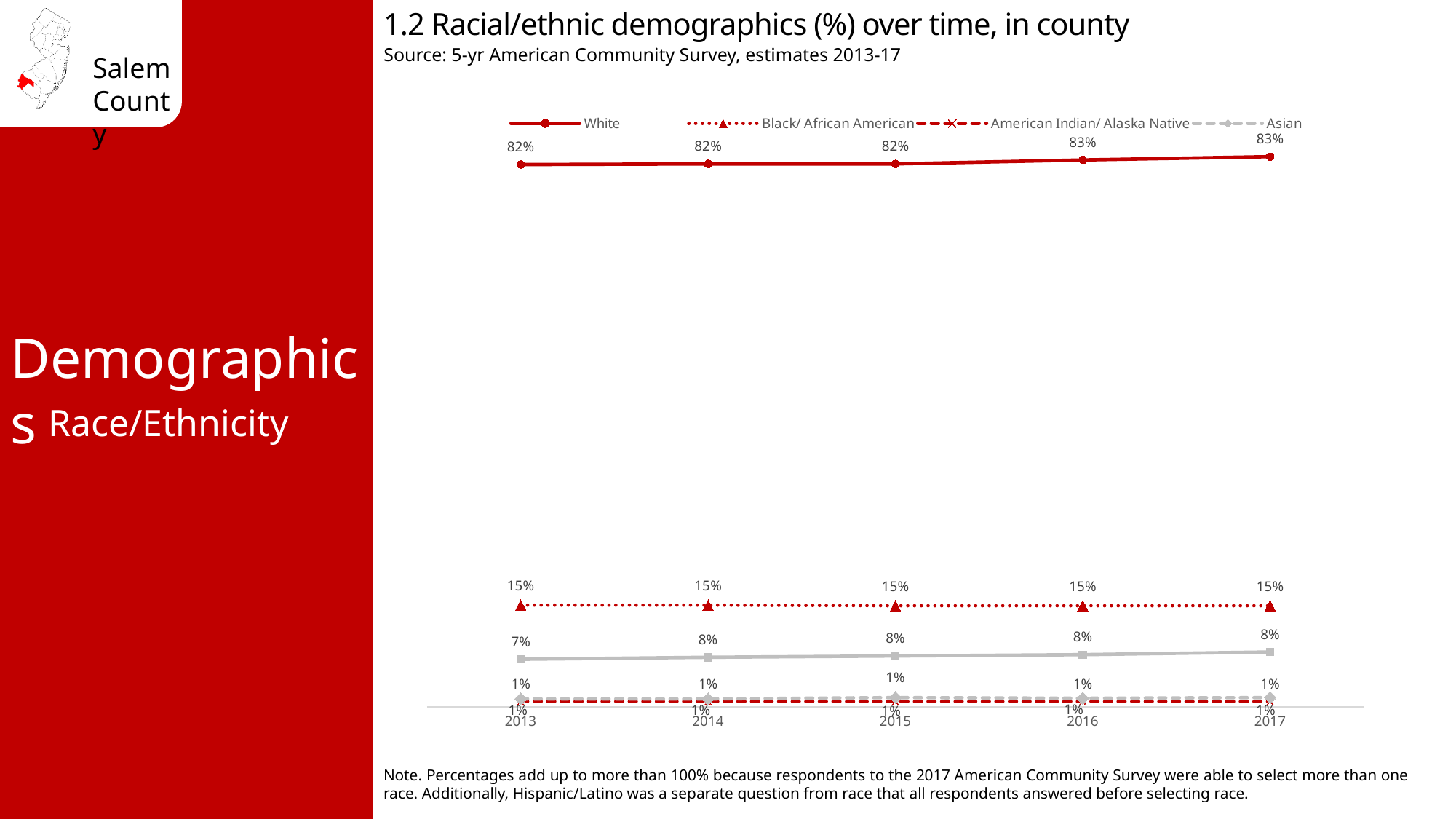
What is the value for White in 2017? 83% How many years are shown on the x axis? 5 What is the first entry listed in the legend? White What kind of chart is shown on the slide? Line chart Does the Black/ African American series change between 2013 and 2017? No, it stays at 15% What is the value for Black/ African American in 2015? 15% What is the value for Asian in 2016? 1% Which series has the highest value in 2017? White Which is larger in 2014, the White value or the Black/ African American value? White What is the value for White in 2013? 82% What is the difference between the White value in 2017 and in 2013? 1 percentage point Does the White series rise or fall from 2013 to 2017? Rises